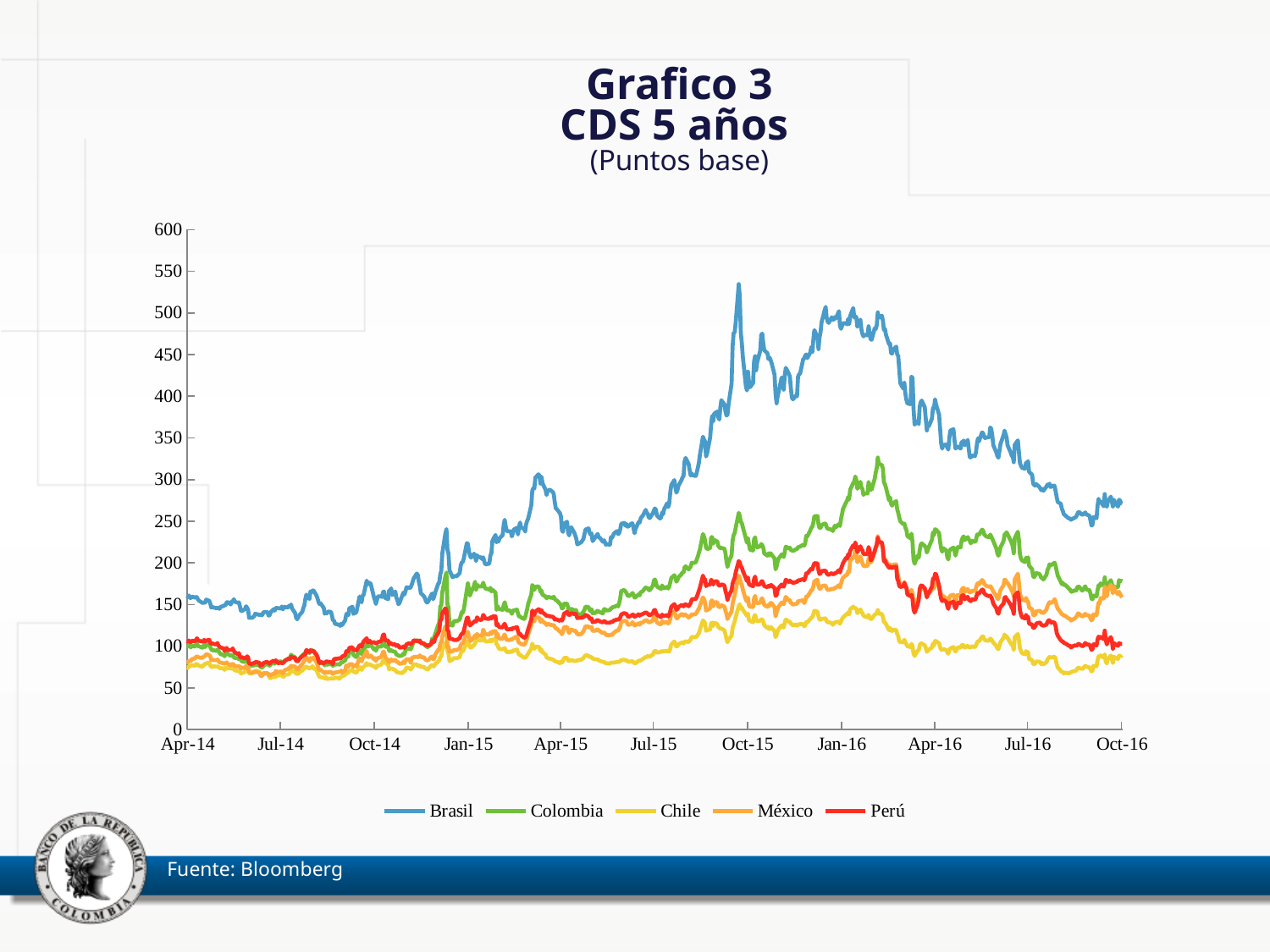
What kind of chart is shown on the slide? Line chart Which country's CDS series reaches the highest level on the chart? Brasil Which country's CDS series stays lowest across the chart? Chile Is the peak value for Brasil greater or less than 500? greater Is the peak value for Colombia greater or less than 300? greater How many series does the legend list? 5 Is the value for Chile ever greater or less than 200 over the whole period? less Does the Brasil series rise or fall between Jan-16 and Oct-16? Fall What is the source cited for the chart? Bloomberg How many date labels are shown on the x axis? 11 Which is larger at Jan-16, the value for Brasil or the value for Perú? Brasil